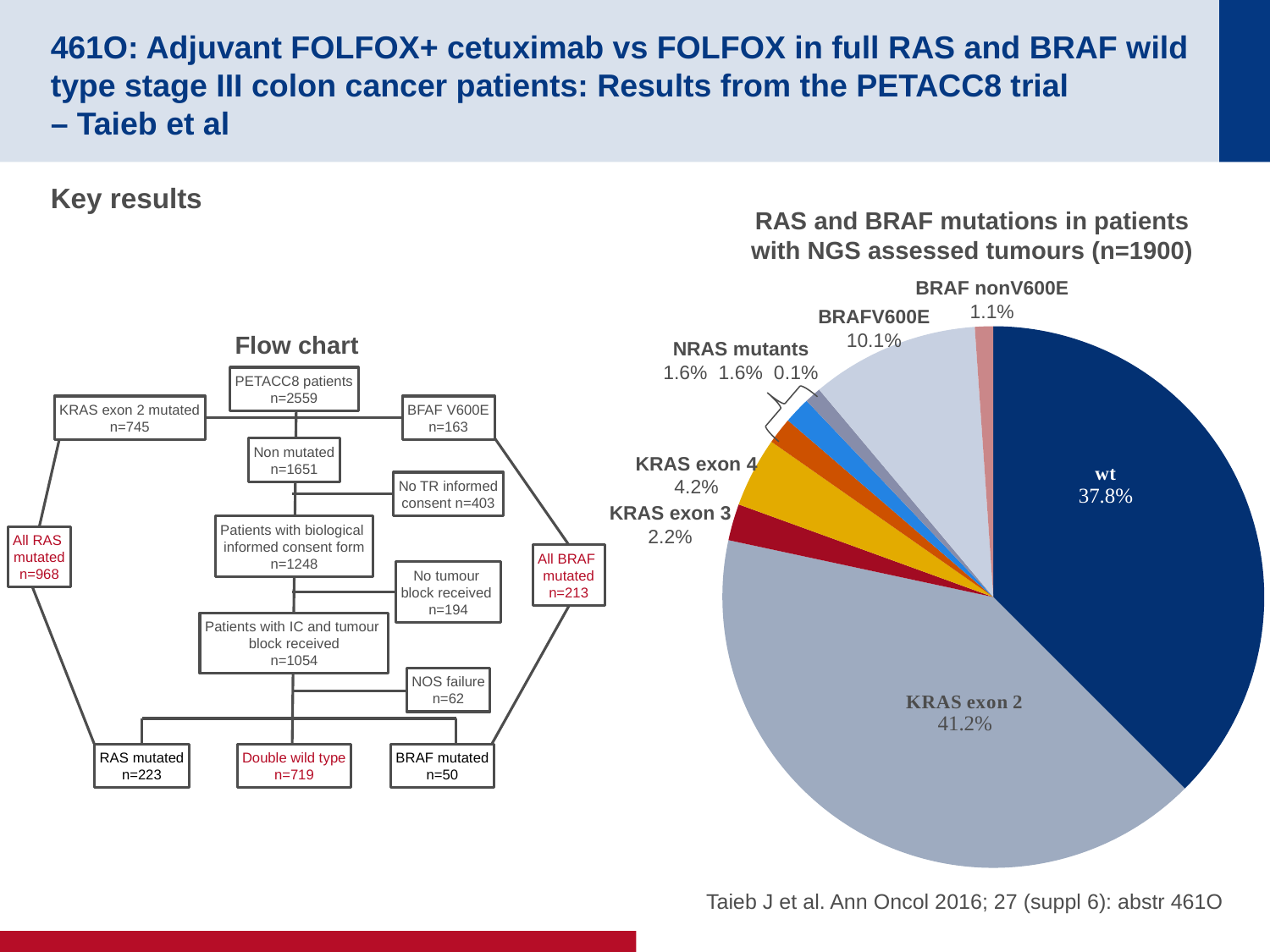
In the pie chart, what percentage is shown for BRAFV600E? 10.1% In the pie chart, which is larger: the wt slice or the KRAS exon 2 slice? KRAS exon 2 In the pie chart, what is the combined percentage of the three NRAS mutant slices (1.6%, 1.6% and 0.1%)? 3.3% What type of chart is used to show the RAS and BRAF mutations on the slide? Pie chart In the pie chart, what percentage is shown for KRAS exon 4? 4.2% In the pie chart, how many percentage points larger is KRAS exon 2 than wt? 3.4% In the pie chart, what percentage of patients are wt (wild type)? 37.8% In the pie chart, what percentage is shown for KRAS exon 3? 2.2% In the pie chart, what percentage is shown for BRAF nonV600E? 1.1% In the pie chart, which category has the largest slice? KRAS exon 2 In the pie chart, what is the difference between the KRAS exon 4 and KRAS exon 3 percentages? 2.0% In the pie chart, what share of patients have a KRAS exon 2 mutation? 41.2%